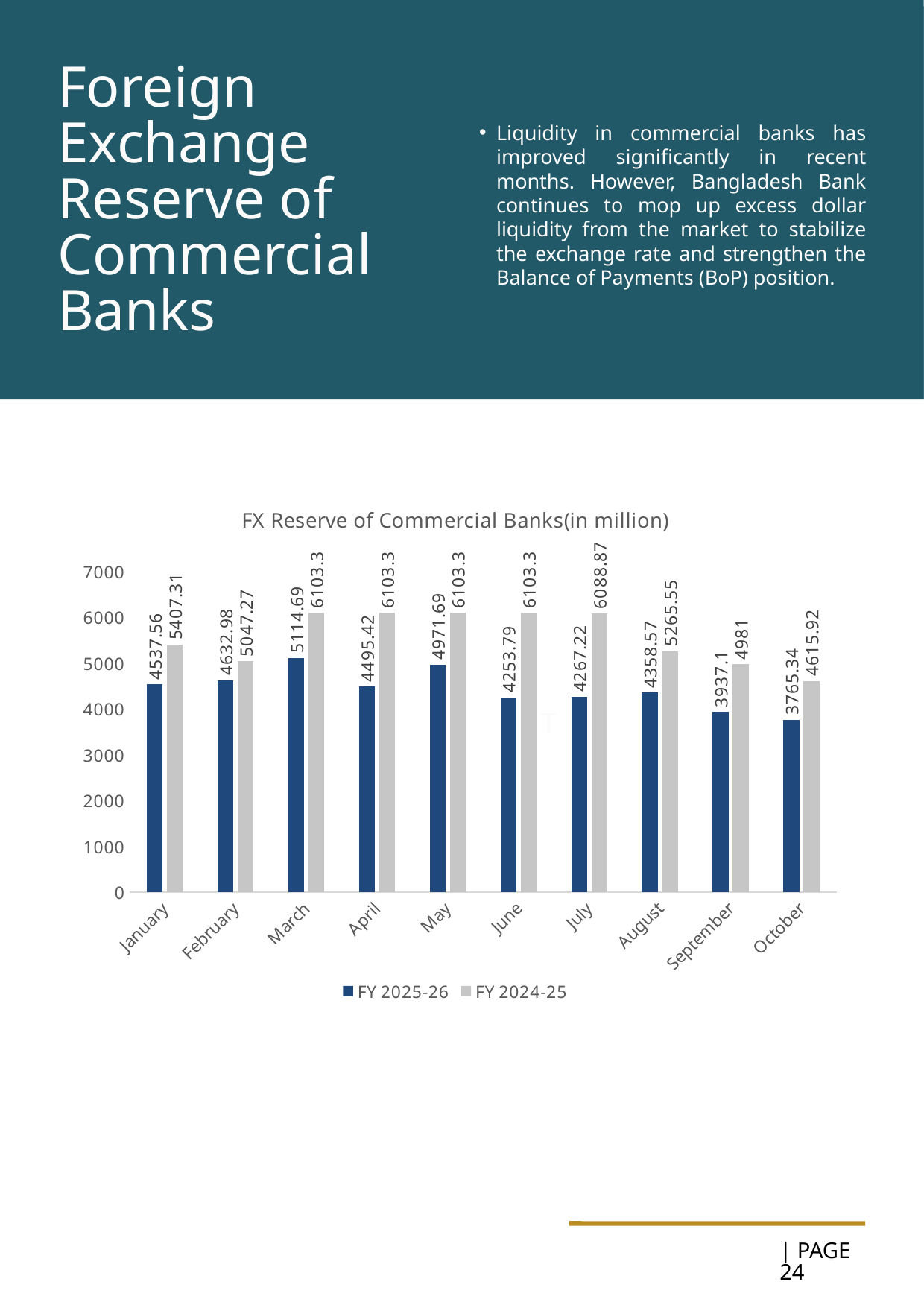
How many months are shown on the x axis? 10 Which month has the highest FY 2025-26 value? March What is the FY 2024-25 value for September? 4981 For January, which series has the larger value, FY 2025-26 or FY 2024-25? FY 2024-25 What is the difference between the FY 2024-25 and FY 2025-26 values for March? 988.61 What kind of chart is shown on the slide? Bar chart What is the FY 2025-26 value for March? 5114.69 Which month has the lowest FY 2024-25 value? October What is the FY 2024-25 value for October? 4615.92 Which month has the lowest FY 2025-26 value? October How many series does the legend list? 2 Do the FY 2025-26 values rise or fall from August to October? Fall